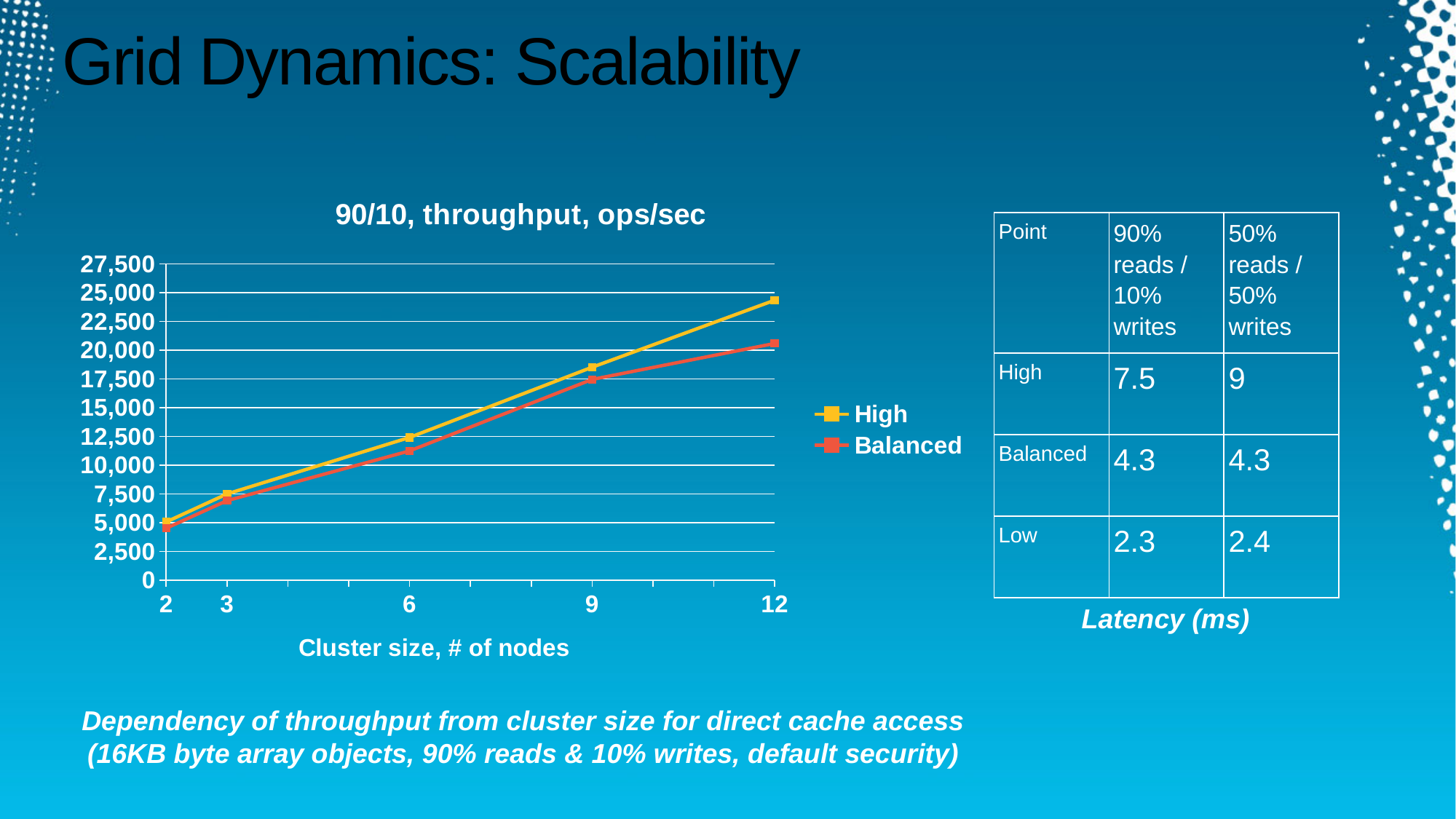
At a cluster size of 12 nodes, which series has the higher throughput, High or Balanced? High At which cluster size is the High series throughput highest? 12 What kind of chart is shown on the slide? line chart What is the title of the chart? 90/10, throughput, ops/sec Is the High series value at 12 nodes greater or less than 22,500? greater How many cluster sizes are plotted along the x axis of the chart? 5 Is the High series value at 6 nodes greater or less than 15,000? less Does the High series rise or fall as cluster size increases? rises At which cluster size is the Balanced series throughput lowest? 2 Is the Balanced series value at 12 nodes greater or less than 17,500? greater What is the label of the chart's x axis? Cluster size, # of nodes How many series does the chart legend list? 2